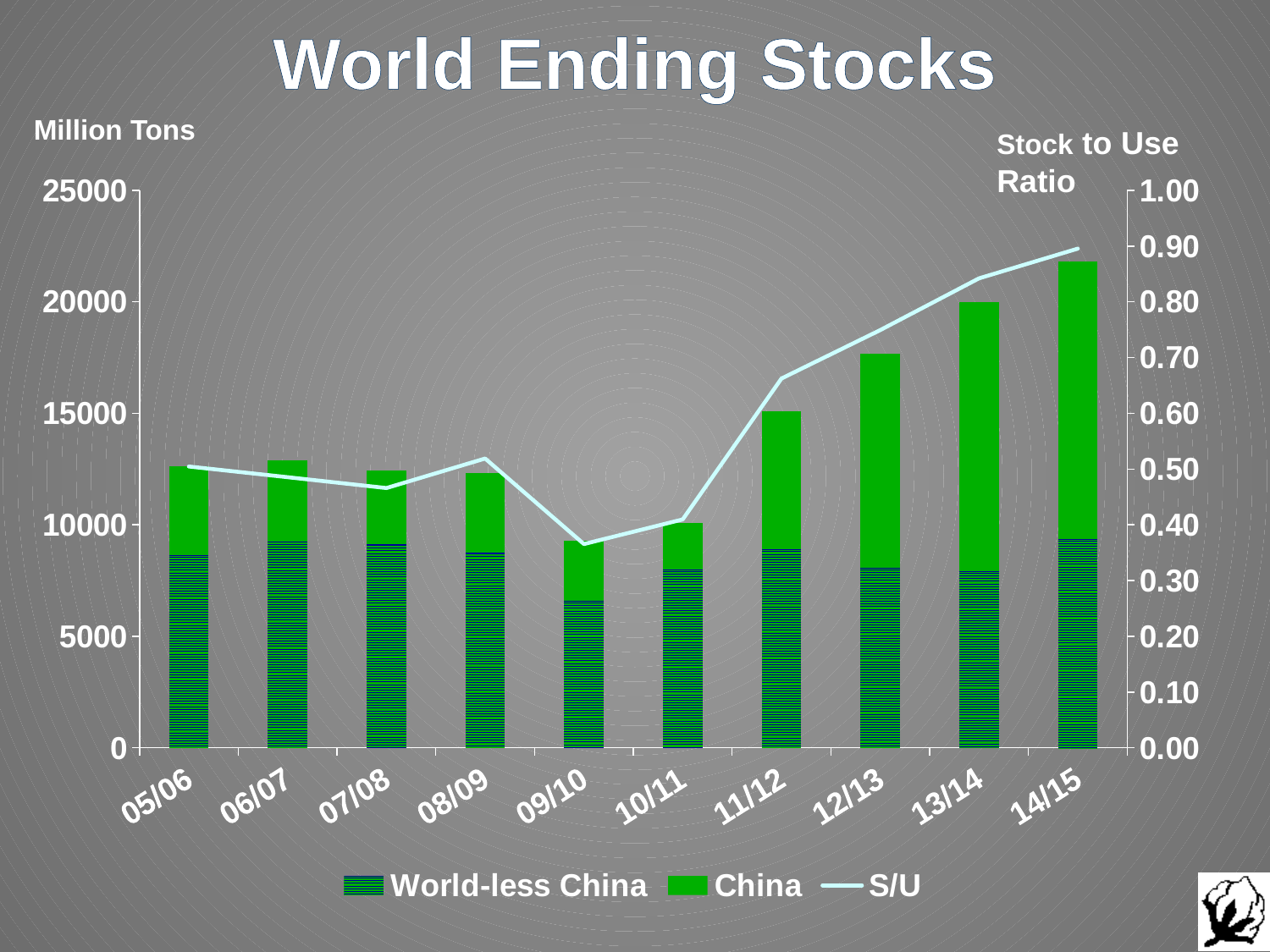
How many series does the legend list? 3 What is the title of the chart? World Ending Stocks Which season has the lowest total ending stocks bar? 09/10 What kind of chart is shown on the slide? A combination of a stacked bar chart and a line chart Which season has the lowest S/U (stock to use ratio) value? 09/10 What unit is shown for the left axis? Million Tons Is the S/U value for 14/15 greater or less than 0.80? greater Which season has the highest total ending stocks bar? 14/15 Is the total ending stocks value for 14/15 greater or less than 20000? greater Does the S/U line rise or fall from 10/11 to 14/15? rise How many seasons (categories) are shown on the x axis? 10 Is the total ending stocks value for 09/10 greater or less than 10000? less